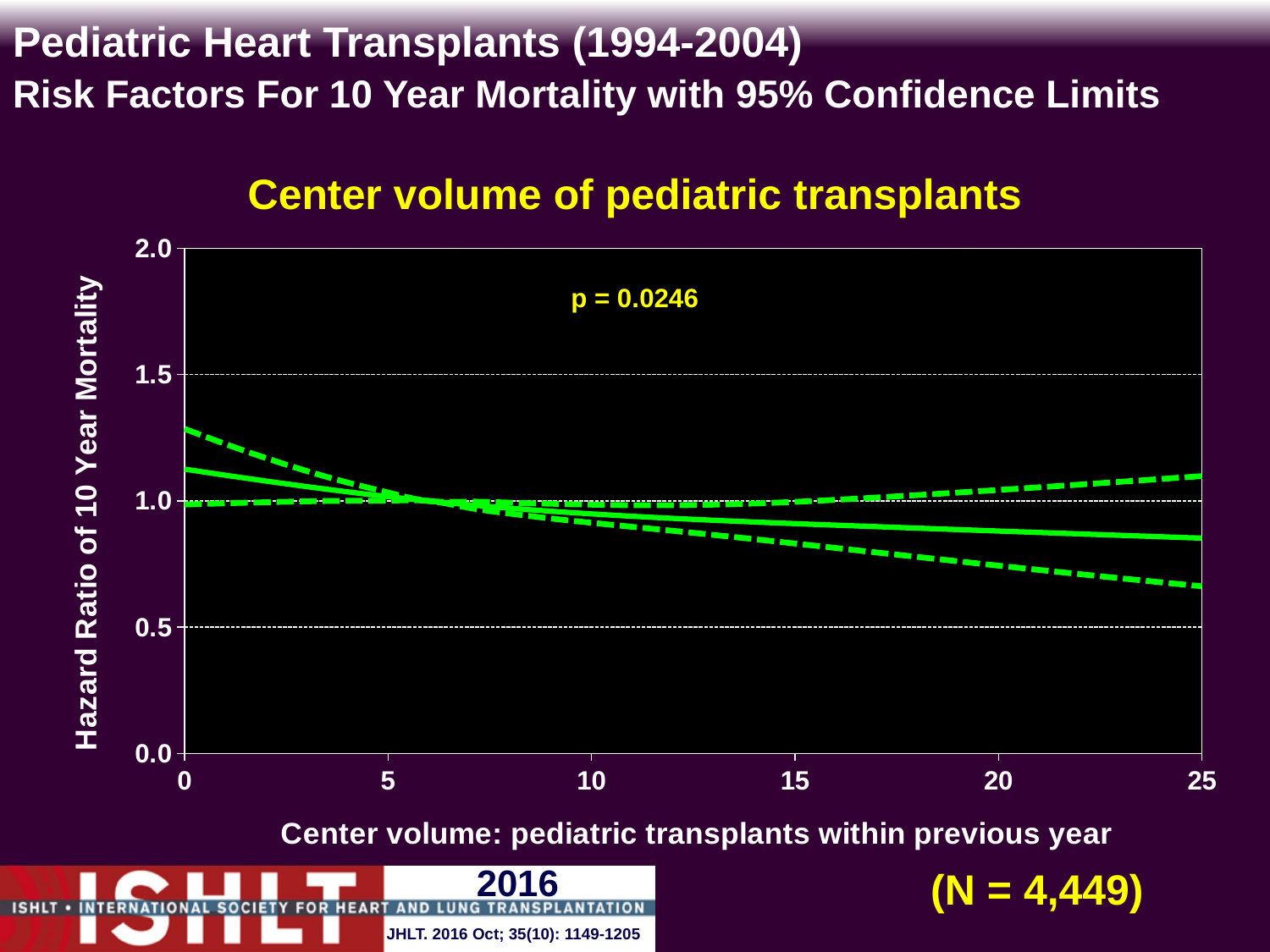
Is the upper dashed confidence limit at a center volume of 0 greater or less than 1.5? less Is the lower dashed confidence limit at a center volume of 25 greater or less than 1.0? less Is the lower dashed confidence limit at a center volume of 25 greater or less than 0.5? greater Does the solid hazard ratio line rise or fall as center volume increases from 0 to 25? fall What kind of chart is shown on the slide? line chart What is the highest value shown on the y axis? 2.0 How many lines are plotted on the chart? 3 What p-value is printed on the chart? p = 0.0246